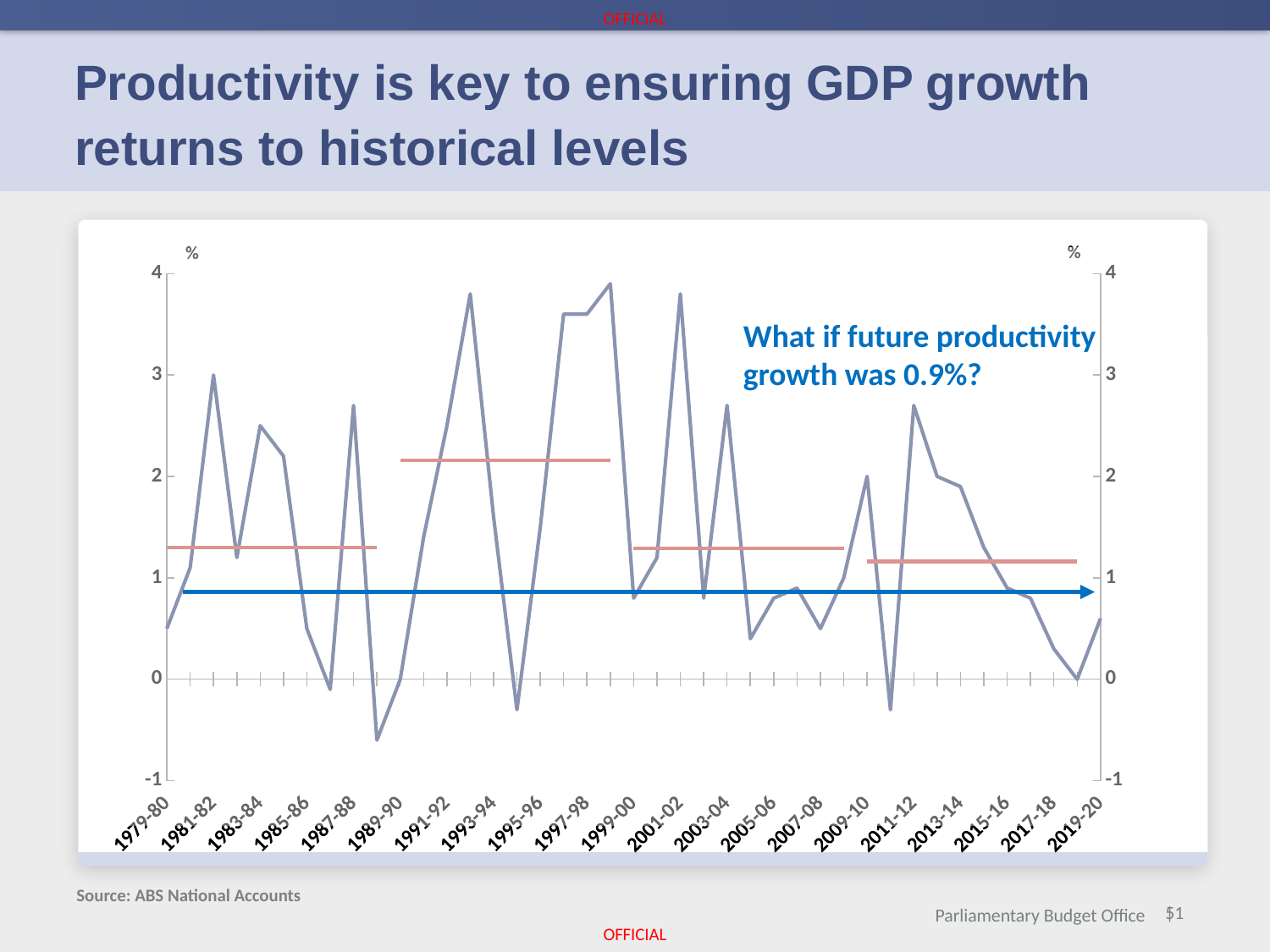
Which year has the lowest value on the chart? 1988-89 Is the value for 2011-12 greater or less than 2? greater What kind of chart is shown on the slide? line chart Which is larger, the value for 1999-00 or the value for 2019-20? 1999-00 What is the source cited for the chart? ABS National Accounts Is the value for 2019-20 greater or less than 1? less Is the value for 1999-00 greater or less than 3? less What unit is shown on the vertical axes of the chart? % Do the values rise or fall from 2011-12 to 2017-18? fall